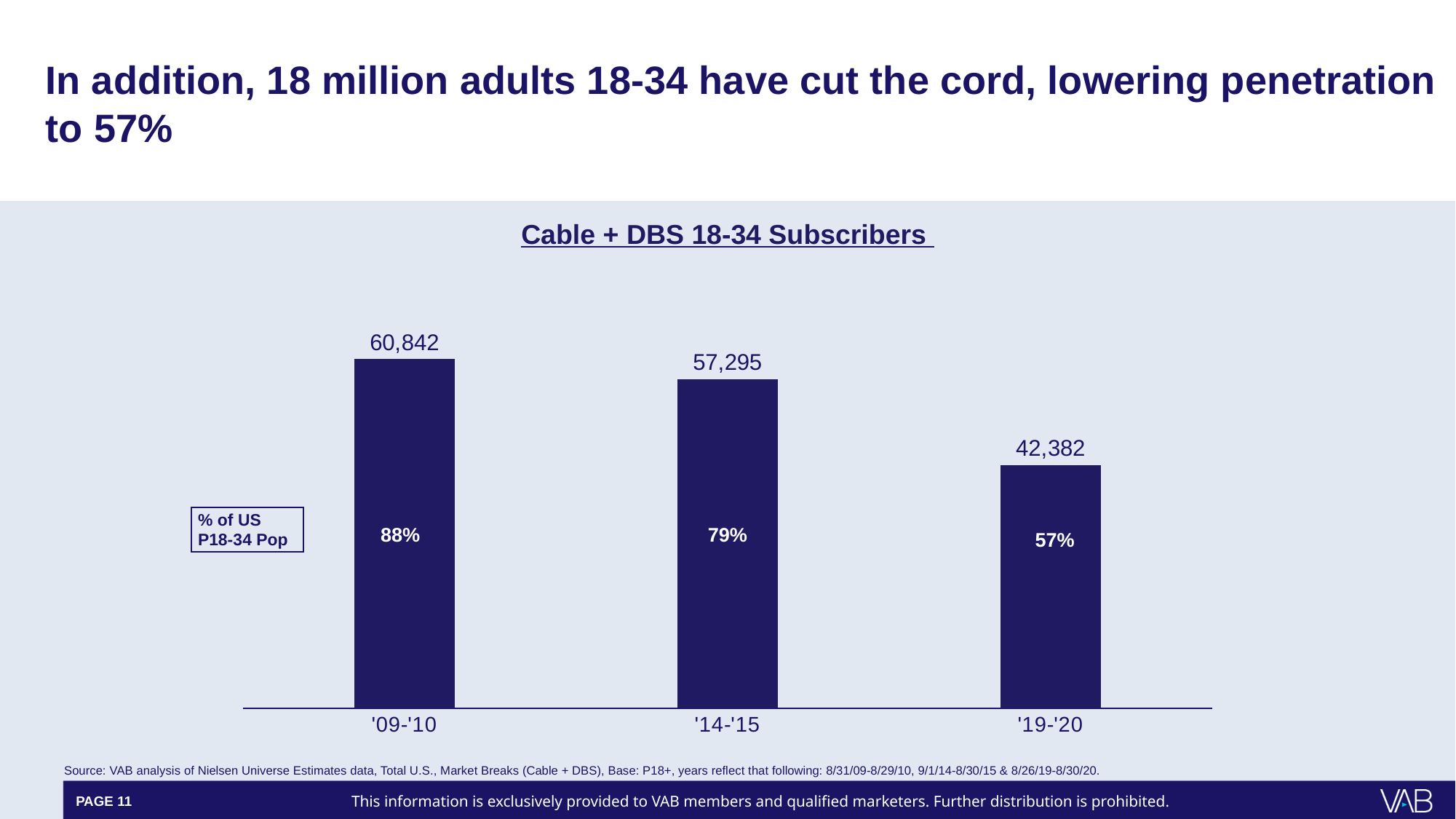
What percentage of the US P18-34 population did Cable + DBS subscribers represent in '09-'10? 88% What is the difference in Cable + DBS 18-34 subscribers between '09-'10 and '19-'20? 18,460 Which period has more Cable + DBS 18-34 subscribers, '09-'10 or '14-'15? '09-'10 How many periods are shown in the Cable + DBS 18-34 Subscribers chart? 3 What is the number of Cable + DBS 18-34 subscribers for '14-'15? 57,295 Which period has the lowest number of Cable + DBS 18-34 subscribers? '19-'20 What type of chart is used to show Cable + DBS 18-34 Subscribers? Bar chart What is the number of Cable + DBS 18-34 subscribers for '19-'20? 42,382 What is the number of Cable + DBS 18-34 subscribers for '09-'10? 60,842 Which period has the highest number of Cable + DBS 18-34 subscribers? '09-'10 What is the difference in Cable + DBS 18-34 subscribers between '14-'15 and '19-'20? 14,913 What percentage of the US P18-34 population did Cable + DBS subscribers represent in '19-'20? 57%